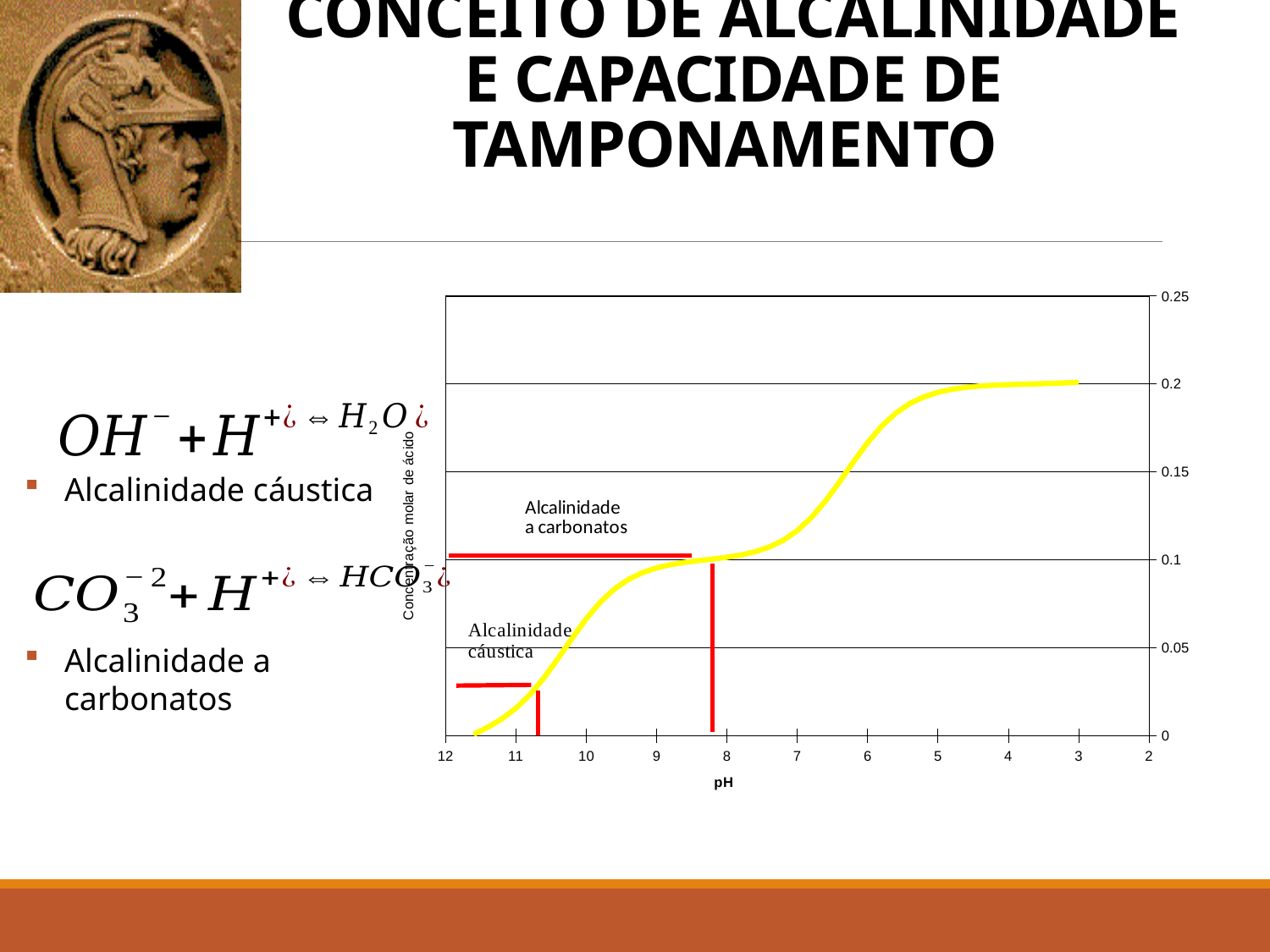
Which has the larger value on the yellow curve, pH 5 or pH 9? pH 5 How many pH tick labels are shown on the x axis? 11 Which has the smaller value on the yellow curve, pH 11 or pH 7? pH 11 Is the value of the yellow curve at pH 10 greater or less than 0.05? greater Is the value of the yellow curve at pH 4 greater or less than 0.15? greater Is the value of the yellow curve at pH 11 greater or less than 0.05? less Moving from left to right along the x axis (from pH 12 to pH 2), does the yellow curve rise or fall? rises What is the label of the y axis of the chart? Concentração molar de ácido What kind of chart is shown on the slide? line chart What is the label of the x axis of the chart? pH